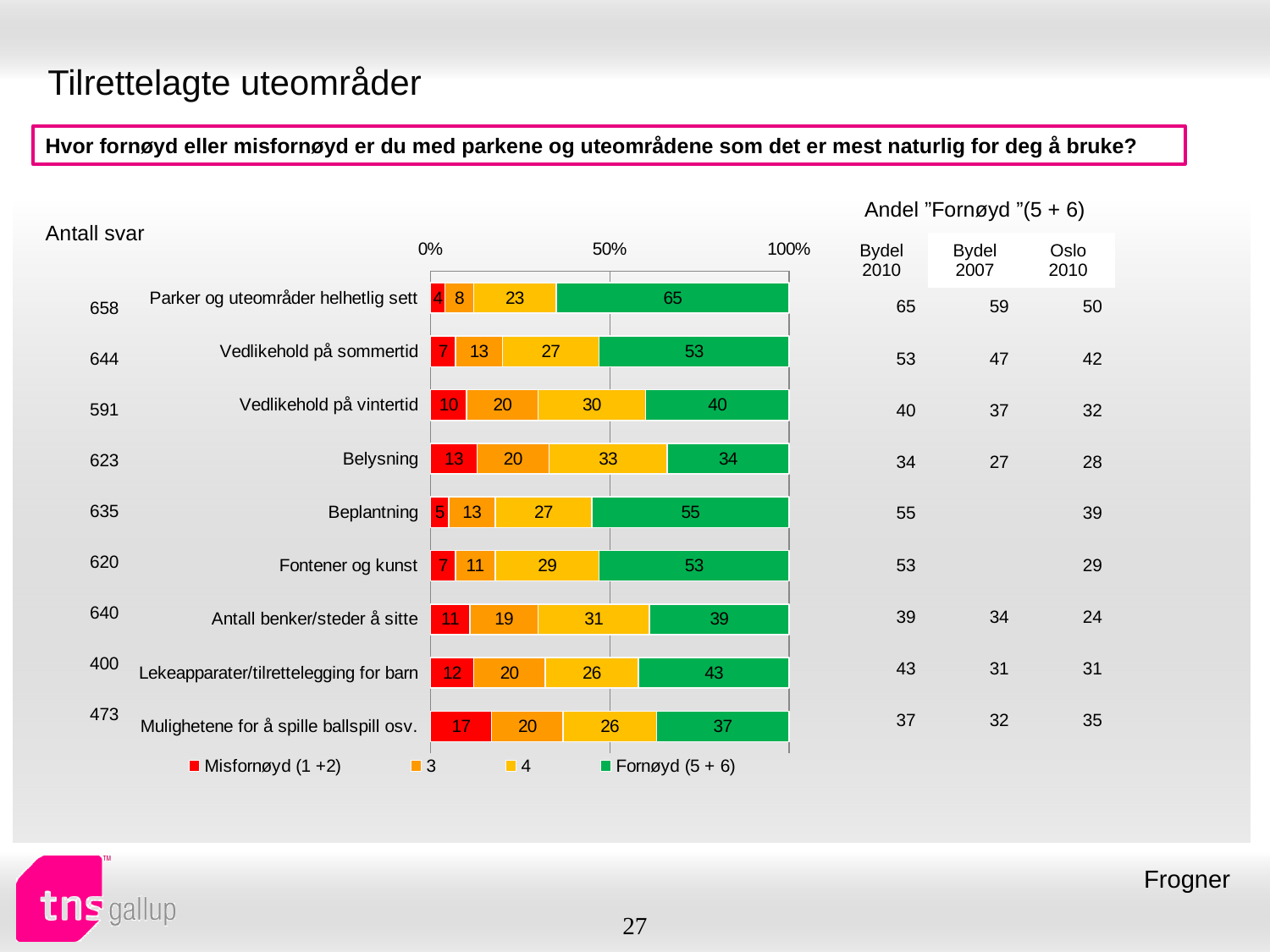
What is the difference between the "Fornøyd (5 + 6)" values for "Parker og uteområder helhetlig sett" and "Belysning"? 31 Which category has the lowest "Fornøyd (5 + 6)" value? Belysning What kind of chart is shown on the slide? Stacked bar chart What is the total of the stacked bar for "Antall benker/steder å sitte"? 100 Which has a larger "Fornøyd (5 + 6)" value, "Vedlikehold på sommertid" or "Vedlikehold på vintertid"? Vedlikehold på sommertid Which category has the highest "Misfornøyd (1 +2)" value? Mulighetene for å spille ballspill osv. How many series does the legend list? 4 What is the value of "Fornøyd (5 + 6)" for "Parker og uteområder helhetlig sett"? 65 What is the value of series "4" for "Belysning"? 33 Which category has the highest "Fornøyd (5 + 6)" value? Parker og uteområder helhetlig sett How many categories are shown in the chart? 9 What is the value of "Misfornøyd (1 +2)" for "Mulighetene for å spille ballspill osv."? 17